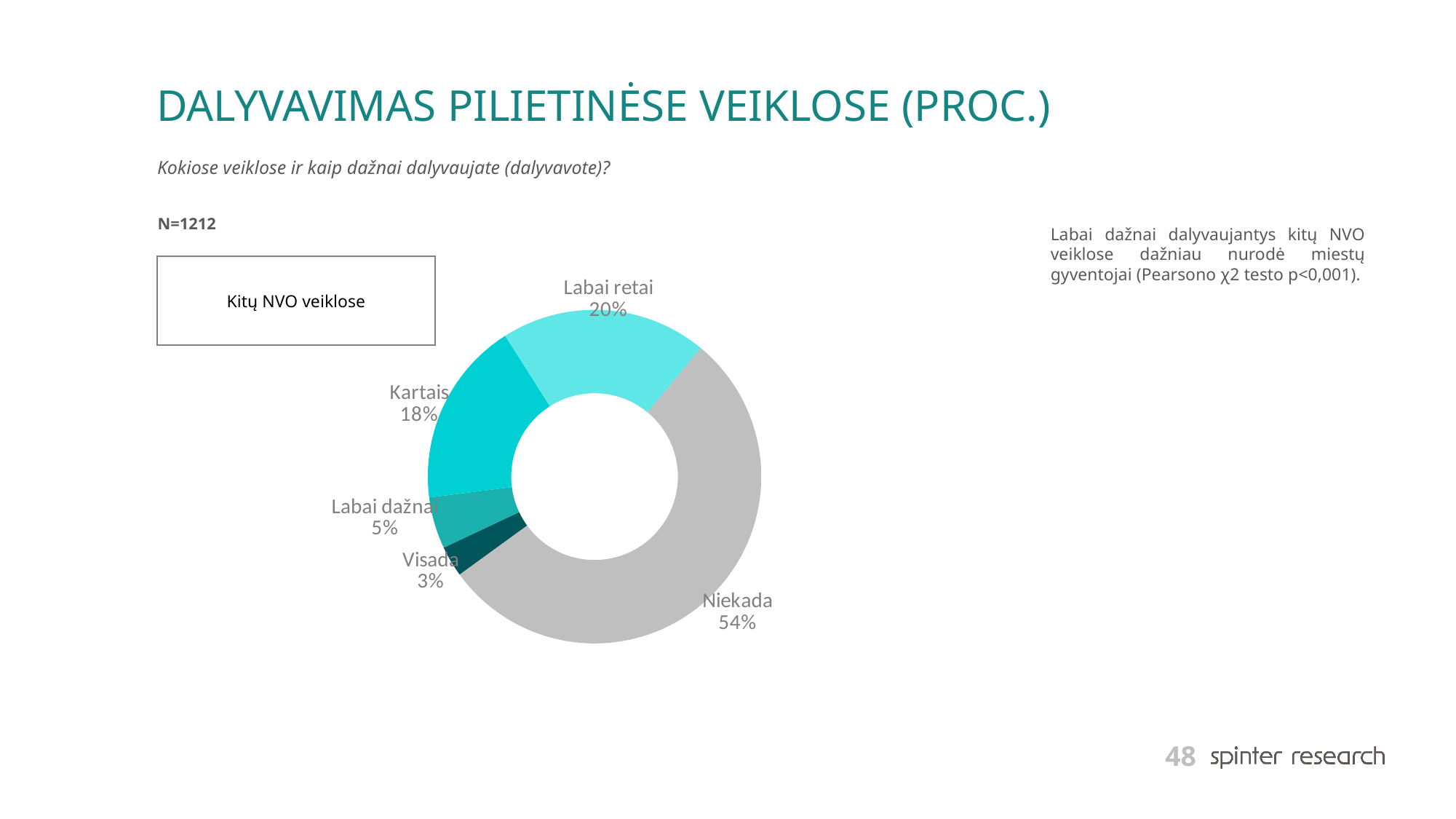
What percentage is shown for "Labai dažnai"? 5% What is the sample size (N) stated on the slide? N=1212 Which category has the largest share of the chart? Niekada Which category has the smallest share of the chart? Visada What is the difference in percentage points between "Niekada" and "Labai retai"? 34 What percentage is shown for "Labai retai"? 20% What percentage is shown for "Kartais"? 18% What kind of chart is shown on the slide? Doughnut (pie) chart What percentage is shown for "Visada"? 3% Which is larger, the share for "Kartais" or the share for "Labai dažnai"? Kartais How many categories are shown in the chart? 5 What share of respondents answered "Niekada" for Kitų NVO veiklose? 54%